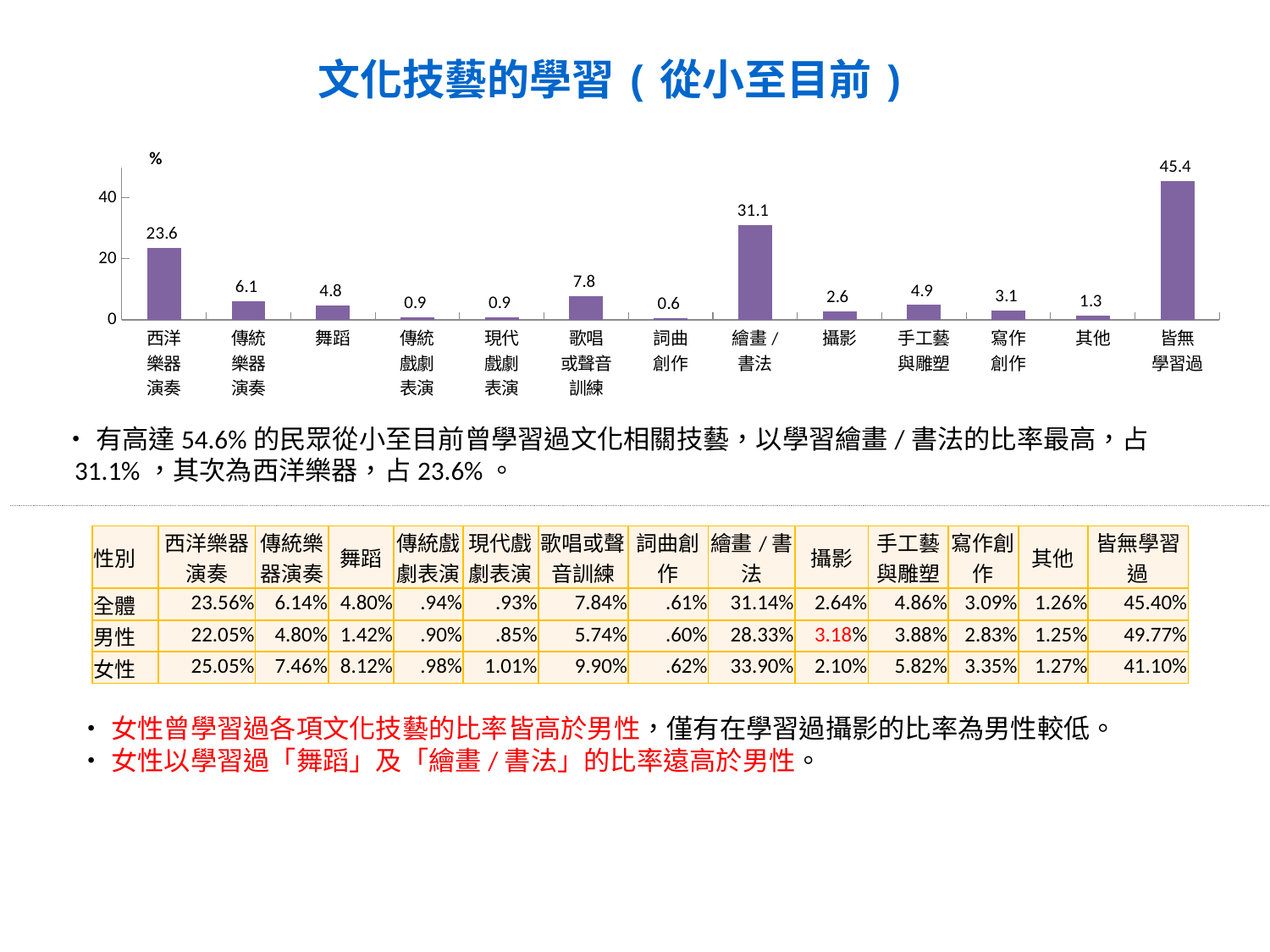
What is the value shown for 歌唱或聲音訓練 in the bar chart? 7.8 Which category has the highest bar in the chart? 皆無學習過 What type of chart is shown on the slide? bar chart What is the value shown for 繪畫／書法 in the bar chart? 31.1 Is the value for 皆無學習過 greater or less than 40? greater Which is larger, the value for 傳統樂器演奏 or the value for 手工藝與雕塑? 傳統樂器演奏 Which category has the lowest bar in the chart? 詞曲創作 What is the difference between the values for 皆無學習過 and 繪畫／書法? 14.3 What is the difference between the values for 西洋樂器演奏 and 傳統樂器演奏? 17.5 How many categories are shown on the x axis of the bar chart? 13 What unit is indicated at the top of the y axis of the chart? % What is the value shown for 西洋樂器演奏 in the bar chart? 23.6